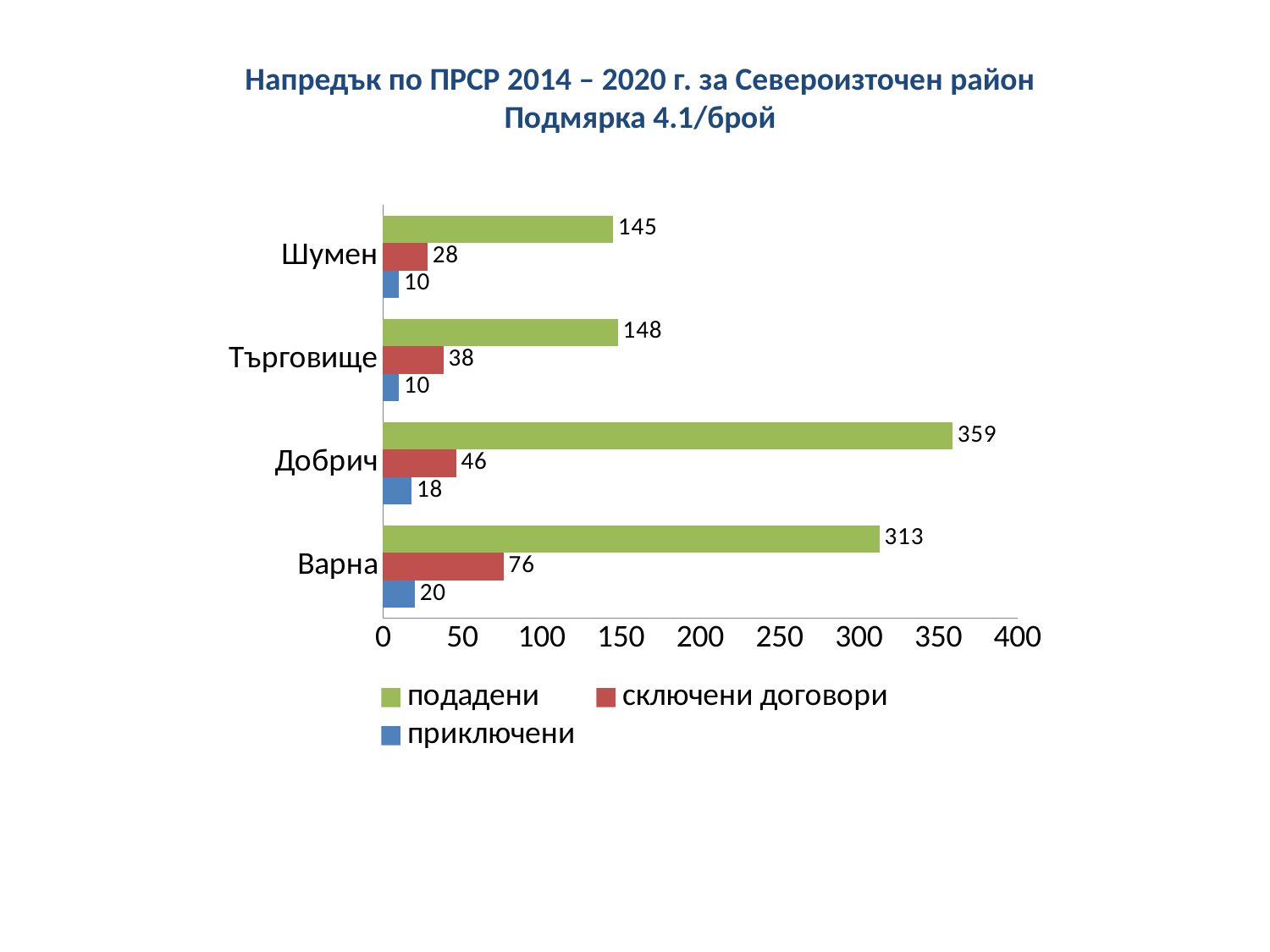
Which category has the lowest value for сключени договори? Шумен Which category has the highest value for подадени? Добрич What is the difference between подадени for Добрич and подадени for Варна? 46 What is the title of the chart? Напредък по ПРСР 2014 – 2020 г. за Североизточен район Подмярка 4.1/брой How many categories are shown on the chart? 4 What is the value of приключени for Шумен? 10 What is the value of сключени договори for Варна? 76 How many series does the legend list? 3 What kind of chart is shown on the slide? bar chart What is the value of подадени for Добрич? 359 Is the value of подадени for Варна greater or less than 300? greater Which is larger: сключени договори for Търговище or сключени договори for Добрич? Добрич